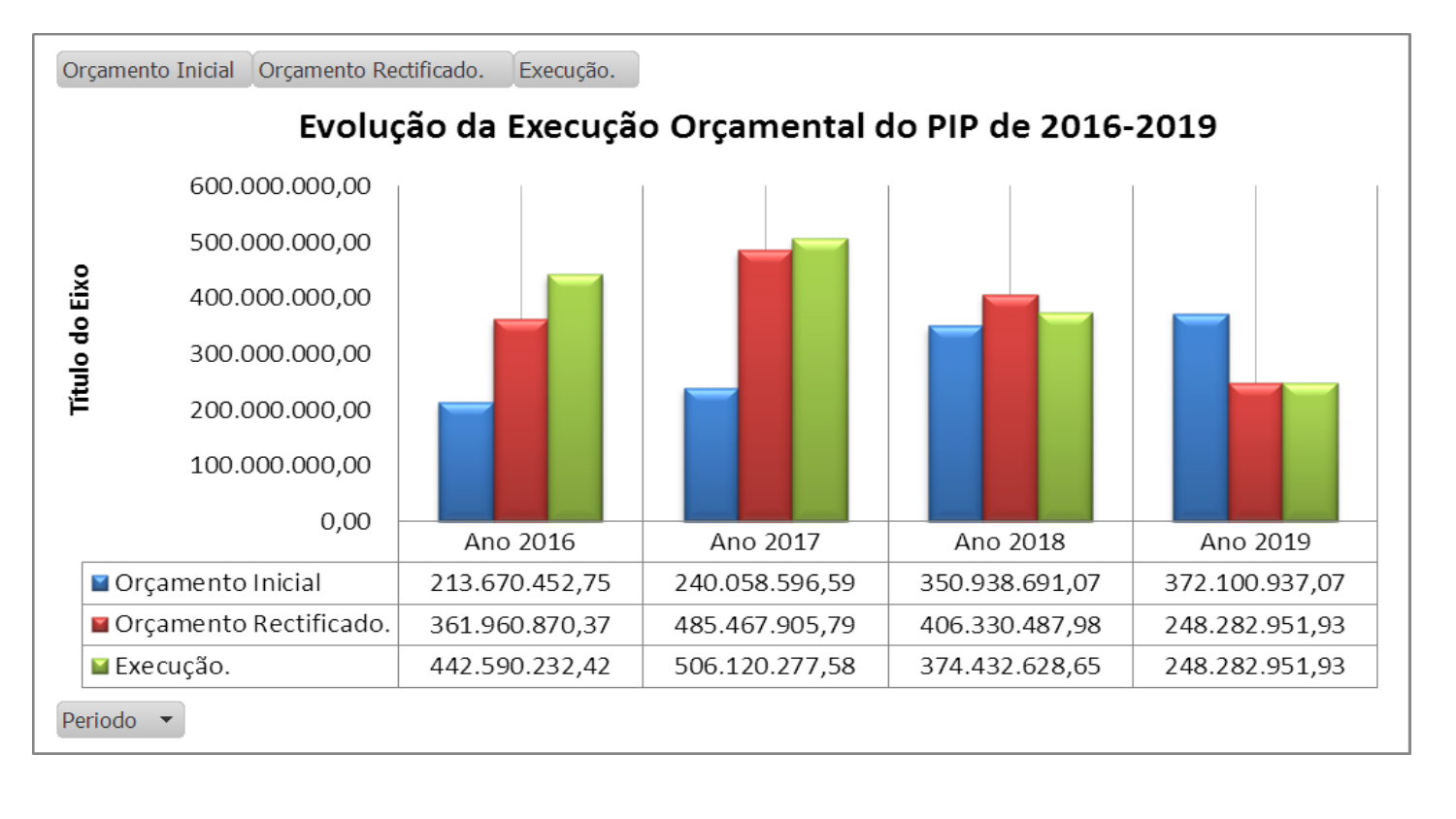
What kind of chart is this? bar chart Is the Orçamento Inicial value for Ano 2019 greater or less than 300.000.000,00? greater What is the difference between Execução. and Orçamento Inicial for Ano 2016? 228.919.779,67 In which year is the Execução. value highest? Ano 2017 In which year is the Orçamento Inicial value lowest? Ano 2016 Does the Orçamento Inicial value rise or fall from Ano 2016 to Ano 2019? rise What is the value of Orçamento Rectificado. for Ano 2018? 406.330.487,98 What is the value of Execução. for Ano 2017? 506.120.277,58 What is the value of Orçamento Inicial for Ano 2016? 213.670.452,75 Which is larger for Ano 2018: Orçamento Rectificado. or Execução.? Orçamento Rectificado. How many series does the chart show? 3 How many years are shown on the x axis? 4